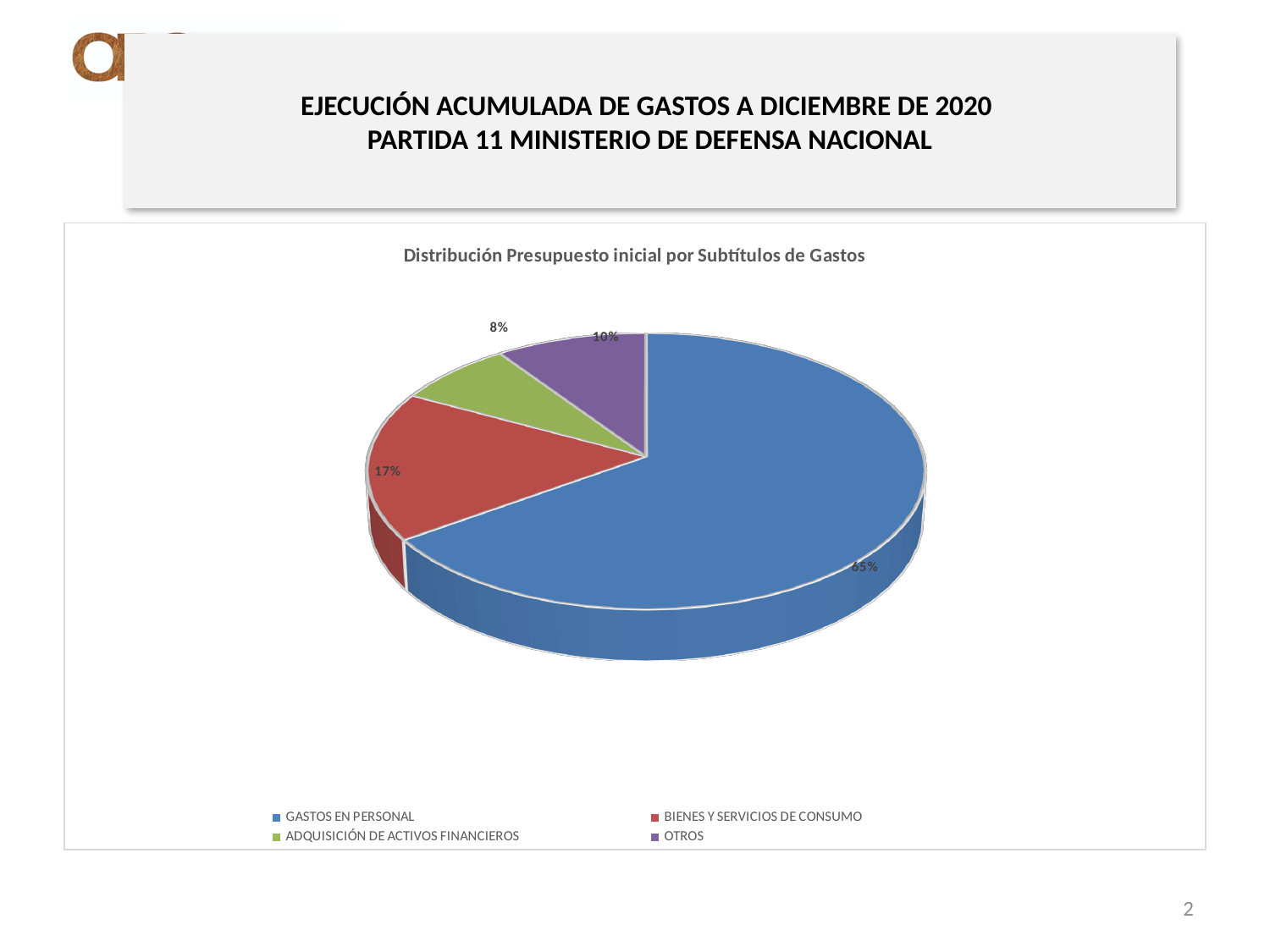
What share of the pie is ADQUISICIÓN DE ACTIVOS FINANCIEROS? 8% What kind of chart is shown on the slide? Pie chart What share of the pie is GASTOS EN PERSONAL? 65% Which category has the largest share of the pie? GASTOS EN PERSONAL What is the title of the chart? Distribución Presupuesto inicial por Subtítulos de Gastos How many entries does the legend list? 4 Which category has the smallest share of the pie? ADQUISICIÓN DE ACTIVOS FINANCIEROS What is the difference in percentage points between GASTOS EN PERSONAL and BIENES Y SERVICIOS DE CONSUMO? 48 percentage points What share of the pie is BIENES Y SERVICIOS DE CONSUMO? 17% How many slices does the pie chart have? 4 Which is larger, the share for OTROS or the share for ADQUISICIÓN DE ACTIVOS FINANCIEROS? OTROS